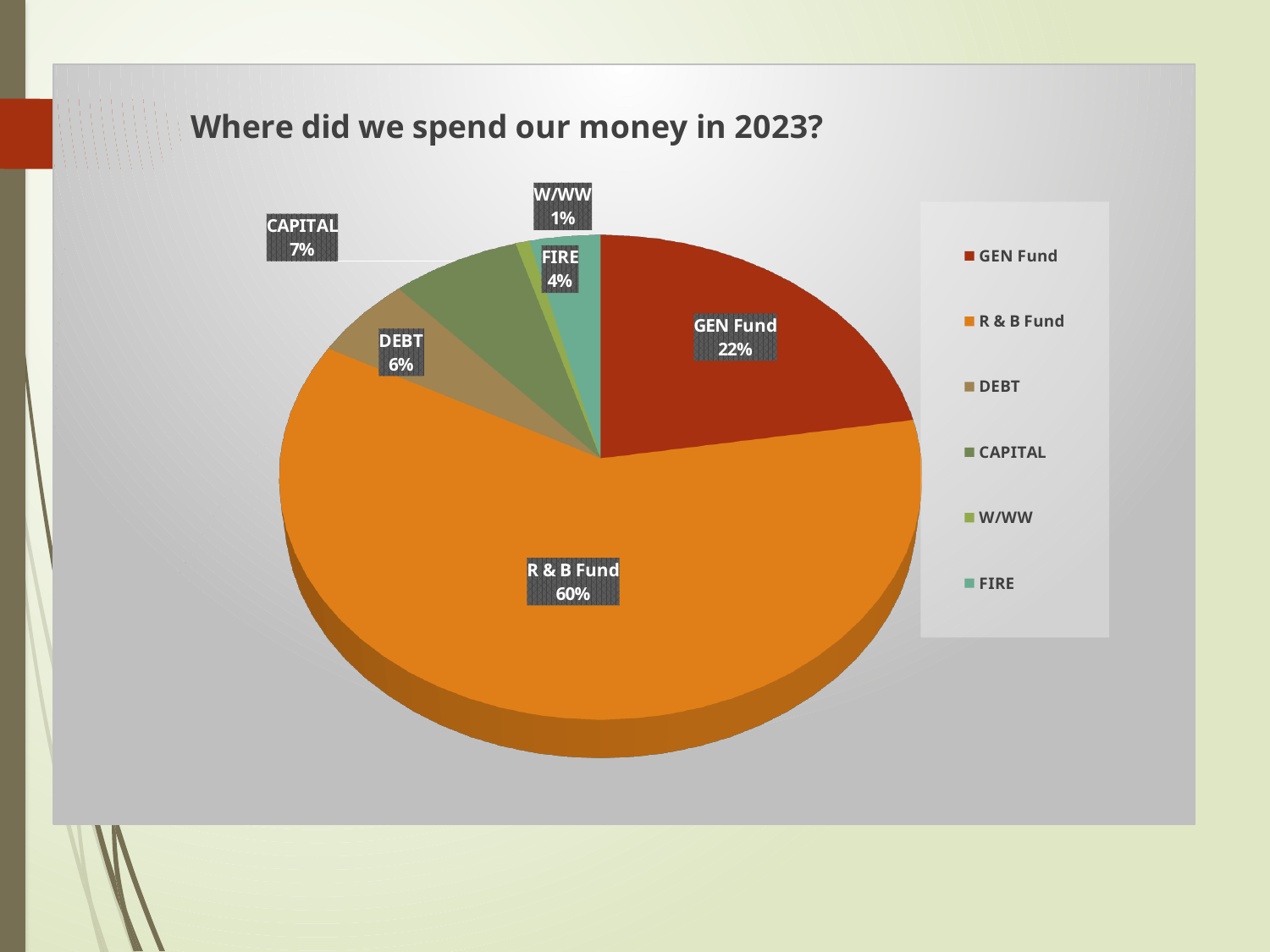
Which category has the smallest slice of the pie? W/WW How many percentage points larger is the R & B Fund share than the GEN Fund share? 38 Which is larger, the CAPITAL share or the DEBT share? CAPITAL What share of spending went to the GEN Fund? 22% How many categories does the pie chart show? 6 What kind of chart is shown on the slide? Pie chart What percentage of spending was on CAPITAL? 7% What share of spending went to the R & B Fund? 60% Which category has the largest slice of the pie? R & B Fund What percentage of spending was on DEBT? 6% What percentage of spending went to FIRE? 4% What is the title of the chart? Where did we spend our money in 2023?